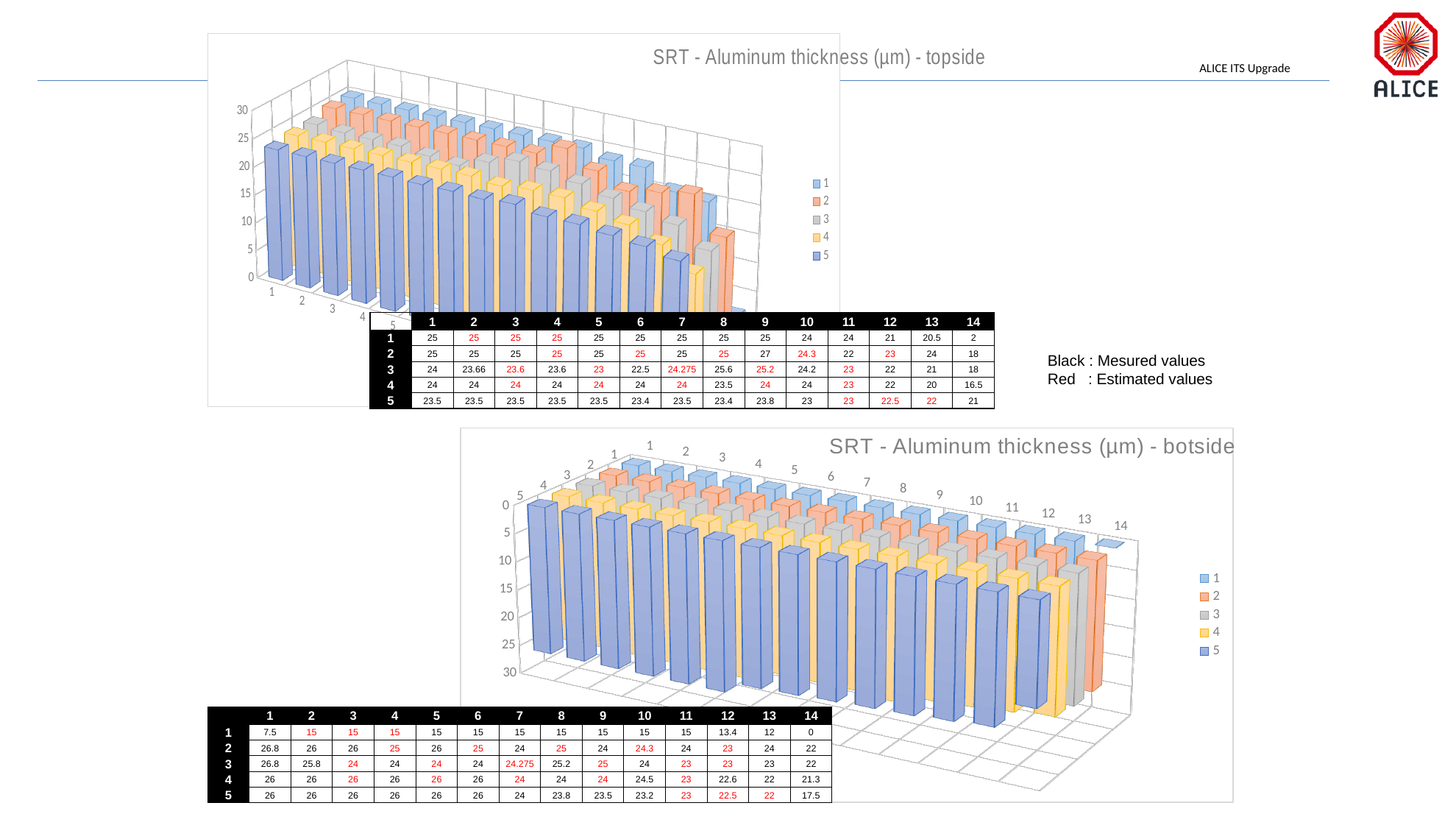
How many series does the legend of the 'SRT - Aluminum thickness (µm) - topside' chart list? 5 In the 'SRT - Aluminum thickness (µm) - topside' chart, what is the value of series 1 at category 14? 2 In the 'SRT - Aluminum thickness (µm) - topside' chart, at category 13, which is larger: series 1 or series 2? series 2 How many categories are plotted along the x axis of the 'SRT - Aluminum thickness (µm) - botside' chart? 14 In the 'SRT - Aluminum thickness (µm) - topside' chart, which category has the lowest value for series 1? 14 What kind of chart is the 'SRT - Aluminum thickness (µm) - topside' chart? bar chart In the 'SRT - Aluminum thickness (µm) - topside' chart, what is the value of series 3 at category 7? 24.275 In the 'SRT - Aluminum thickness (µm) - botside' chart, what is the value of series 4 at category 14? 21.3 According to the slide, what do the red values in the tables represent? Estimated values In the 'SRT - Aluminum thickness (µm) - botside' chart, what is the value of series 1 at category 1? 7.5 In the 'SRT - Aluminum thickness (µm) - botside' chart, what is the difference between the series 5 values at category 1 and category 14? 8.5 In the 'SRT - Aluminum thickness (µm) - botside' chart, which category has the lowest value for series 1? 14